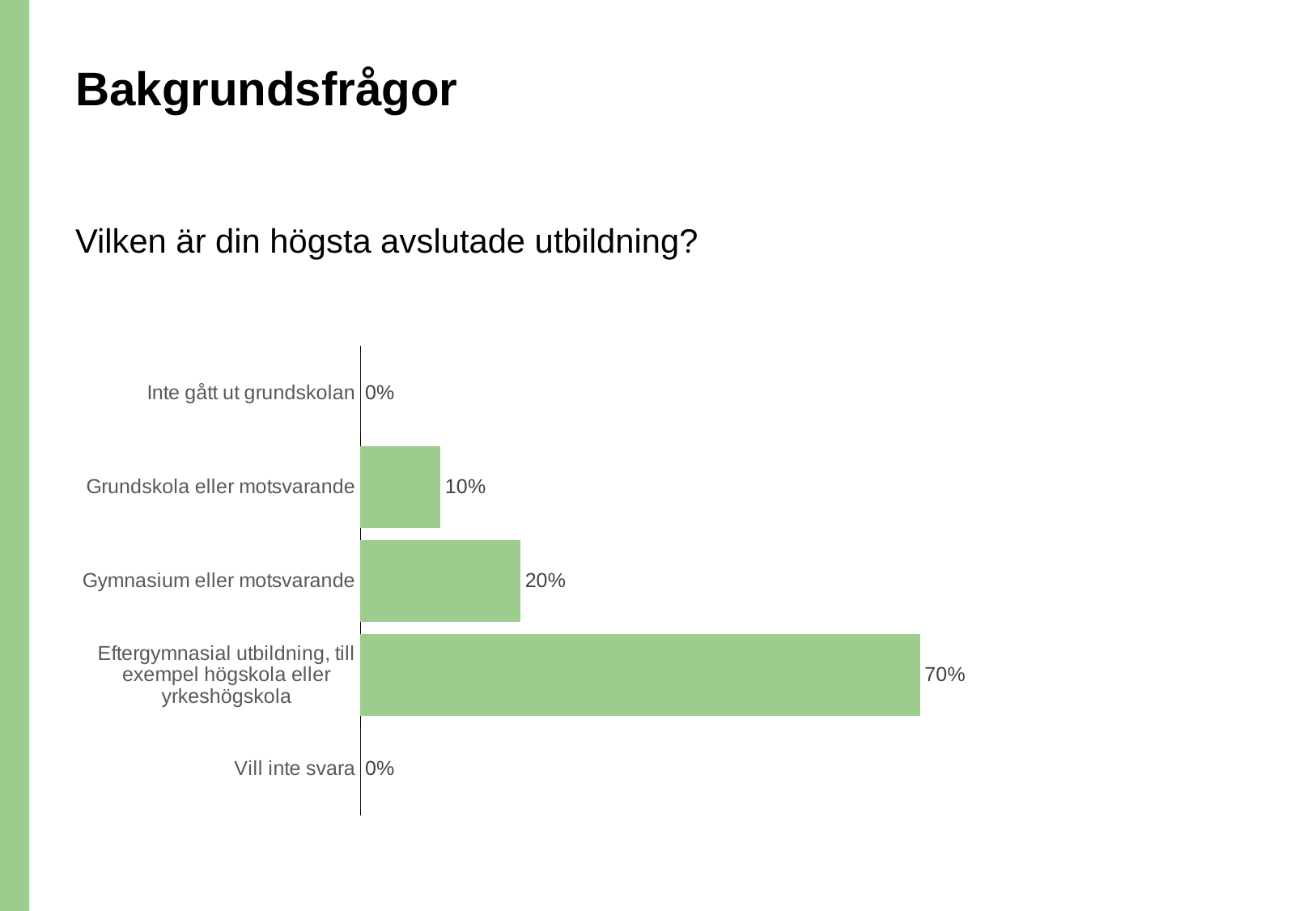
What is the value for "Grundskola eller motsvarande"? 10% What is the difference between the values for "Gymnasium eller motsvarande" and "Grundskola eller motsvarande"? 10% What is the value for "Gymnasium eller motsvarande"? 20% What question does the chart on the slide present results for? Vilken är din högsta avslutade utbildning? What kind of chart is shown on the slide? Bar chart What is the value for "Eftergymnasial utbildning, till exempel högskola eller yrkeshögskola"? 70% What is the difference between the values for "Eftergymnasial utbildning, till exempel högskola eller yrkeshögskola" and "Gymnasium eller motsvarande"? 50% What is the value for "Vill inte svara"? 0% How many categories have a value of 0%? 2 Which is larger, the value for "Grundskola eller motsvarande" or the value for "Gymnasium eller motsvarande"? Gymnasium eller motsvarande Which category has the highest value? Eftergymnasial utbildning, till exempel högskola eller yrkeshögskola How many categories are shown in the chart? 5